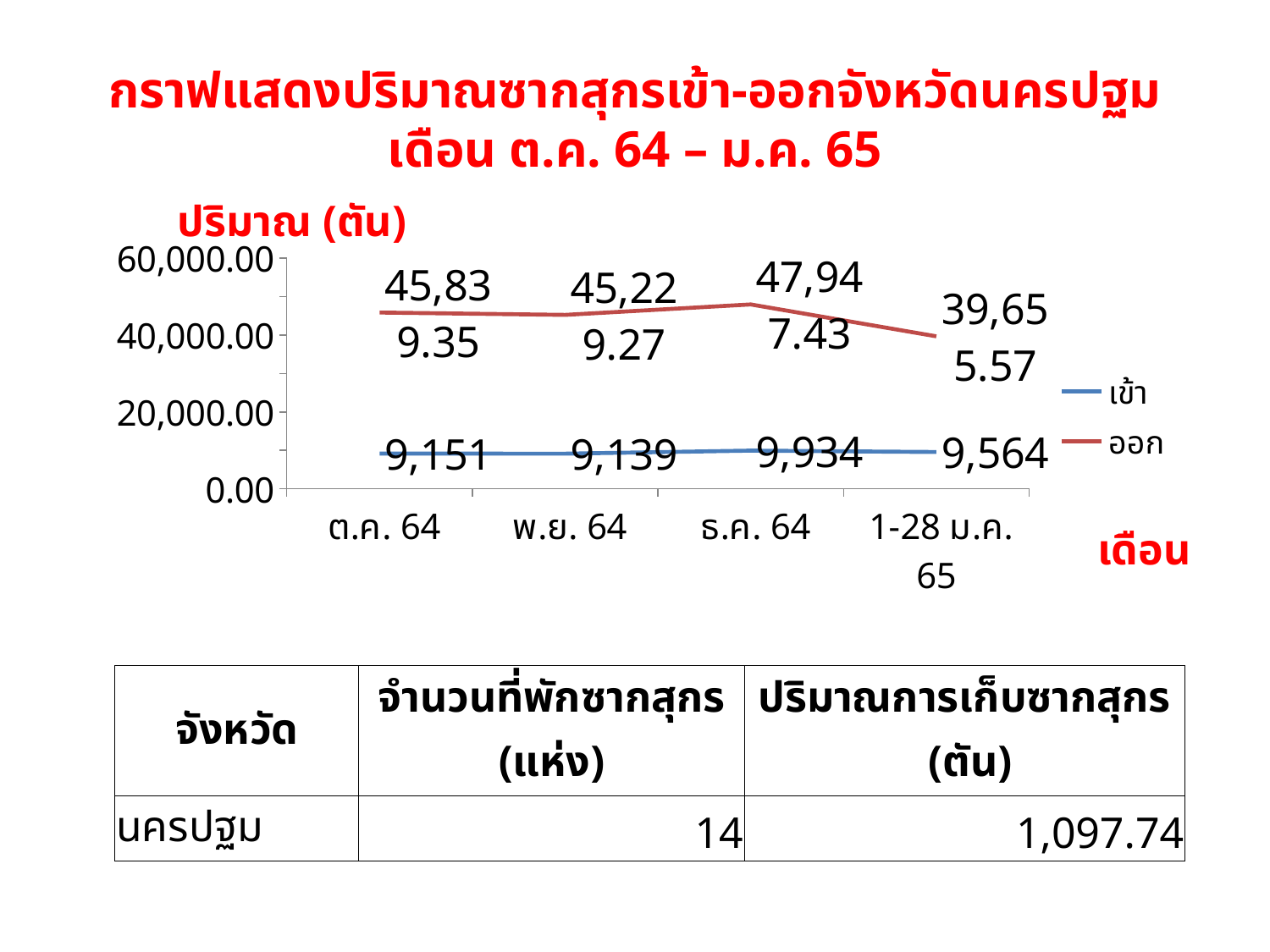
In which month is the ออก series lowest? 1-28 ม.ค. 65 How many months (categories) are plotted on the x axis? 4 What is the value of ออก for ธ.ค. 64? 47,947.43 What is the value of เข้า for ต.ค. 64? 9,151 Is the value for เข้า in ต.ค. 64 greater or less than 20,000? less What is the value of เข้า for ธ.ค. 64? 9,934 Does the ออก series rise or fall from ธ.ค. 64 to 1-28 ม.ค. 65? fall What kind of chart is shown on the slide? line chart In which month is the เข้า series highest? ธ.ค. 64 In ธ.ค. 64, which series has the larger value, เข้า or ออก? ออก How many series does the chart legend list? 2 What is the difference between the เข้า values for ธ.ค. 64 and ต.ค. 64? 783